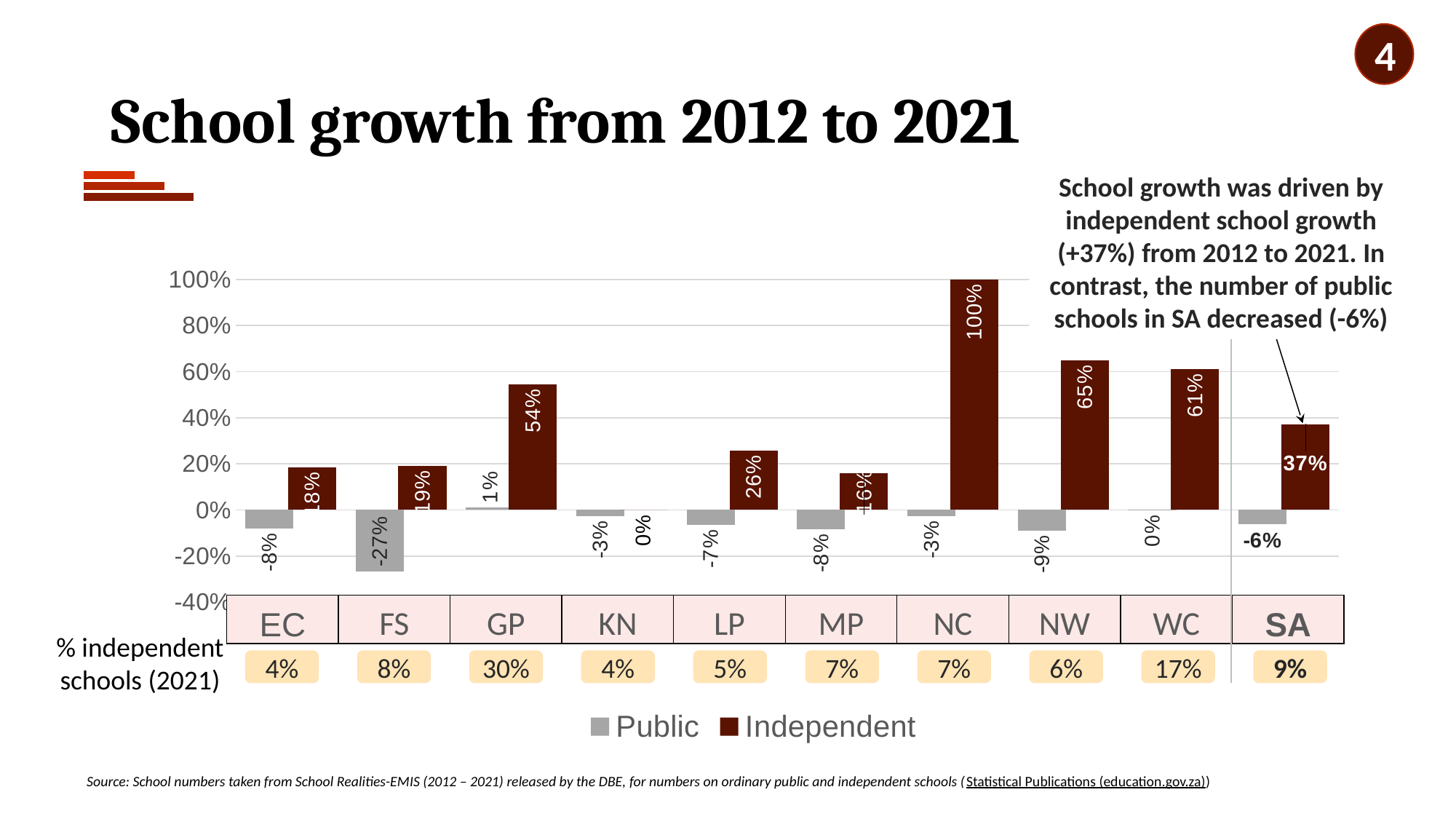
What is the Independent school growth value for NC? 100% What is the difference between the Independent growth for NW and WC? 4 percentage points What is the Public school growth value for FS? -27% What is the Independent school growth value for SA? 37% How many categories are shown on the x axis of the chart? 10 Which is larger, the Independent growth for GP or for LP? GP What kind of chart is shown on the slide? Bar chart How many series does the legend list? 2 Is the Independent growth value for EC greater or less than 20%? less Which province has the highest Independent school growth? NC What is the Public school growth value for GP? 1% Which category has the lowest Public school growth? FS